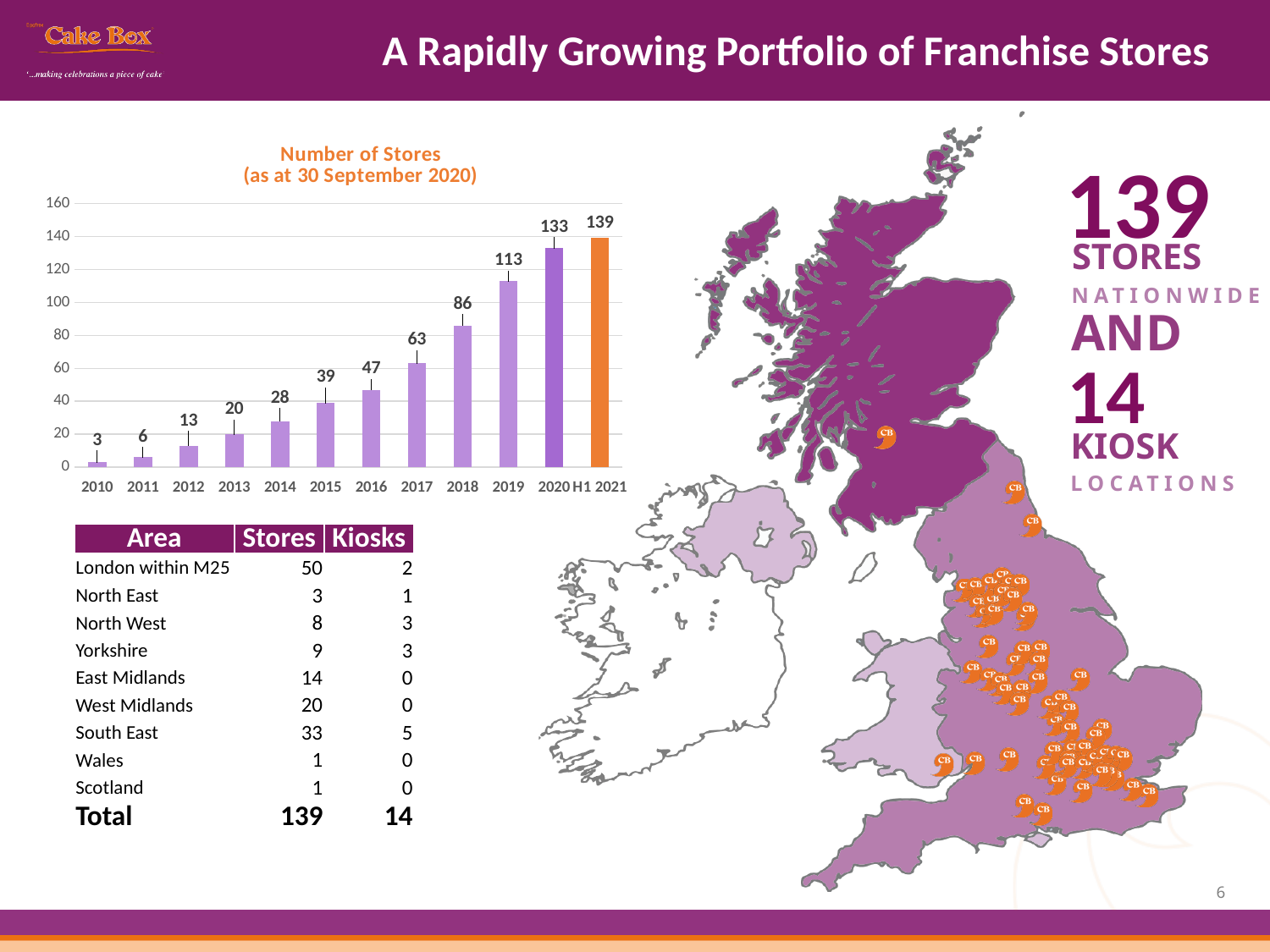
What is the number of stores shown for 2018 in the Number of Stores chart? 86 What is the number of stores shown for H1 2021 in the Number of Stores chart? 139 What type of chart is the Number of Stores chart? Bar chart Which period has the highest number of stores in the Number of Stores chart? H1 2021 Which year has the lowest number of stores in the Number of Stores chart? 2010 How many periods are plotted on the x axis of the Number of Stores chart? 12 What is the difference in the number of stores between 2017 and 2016 in the Number of Stores chart? 16 Do the values in the Number of Stores chart rise or fall from 2010 to H1 2021? Rise What is the difference in the number of stores between 2020 and 2019 in the Number of Stores chart? 20 What is the number of stores shown for 2014 in the Number of Stores chart? 28 Is the number of stores for 2019 greater or less than 100 in the Number of Stores chart? greater In the Number of Stores chart, which is larger: the value for 2015 or the value for 2013? 2015